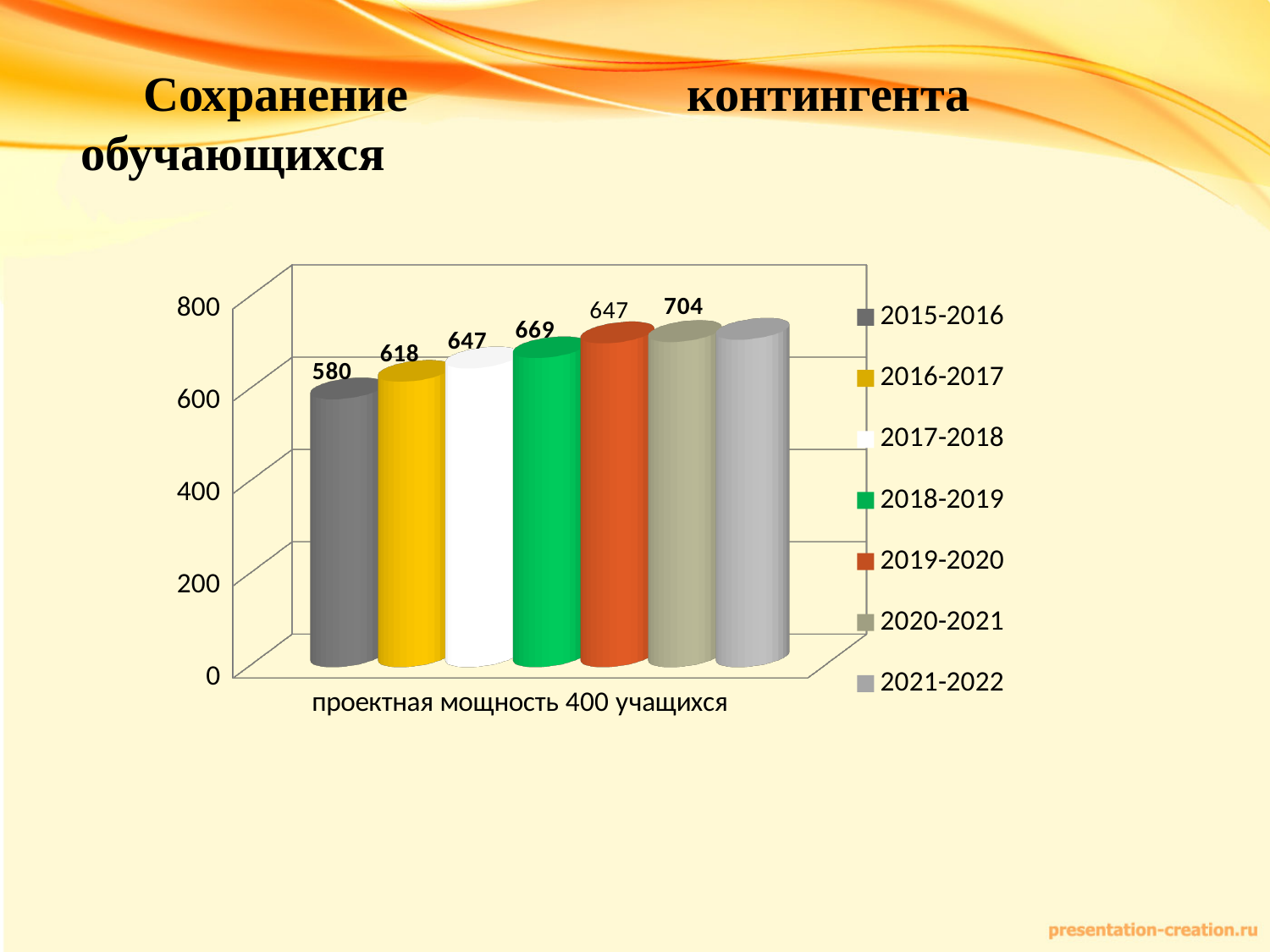
Which series has the lowest value? 2015-2016 What is the value for the 2020-2021 series? 704 What is the value for the 2018-2019 series? 669 What is the value for the 2015-2016 series? 580 How many series does the legend list? 7 What is the difference between the values for 2020-2021 and 2015-2016? 124 What is the value for the 2019-2020 series? 647 What kind of chart is shown on the slide? bar chart Is the value for 2021-2022 greater or less than 600? greater What is the category label shown on the x axis of the chart? проектная мощность 400 учащихся What is the value for the 2016-2017 series? 618